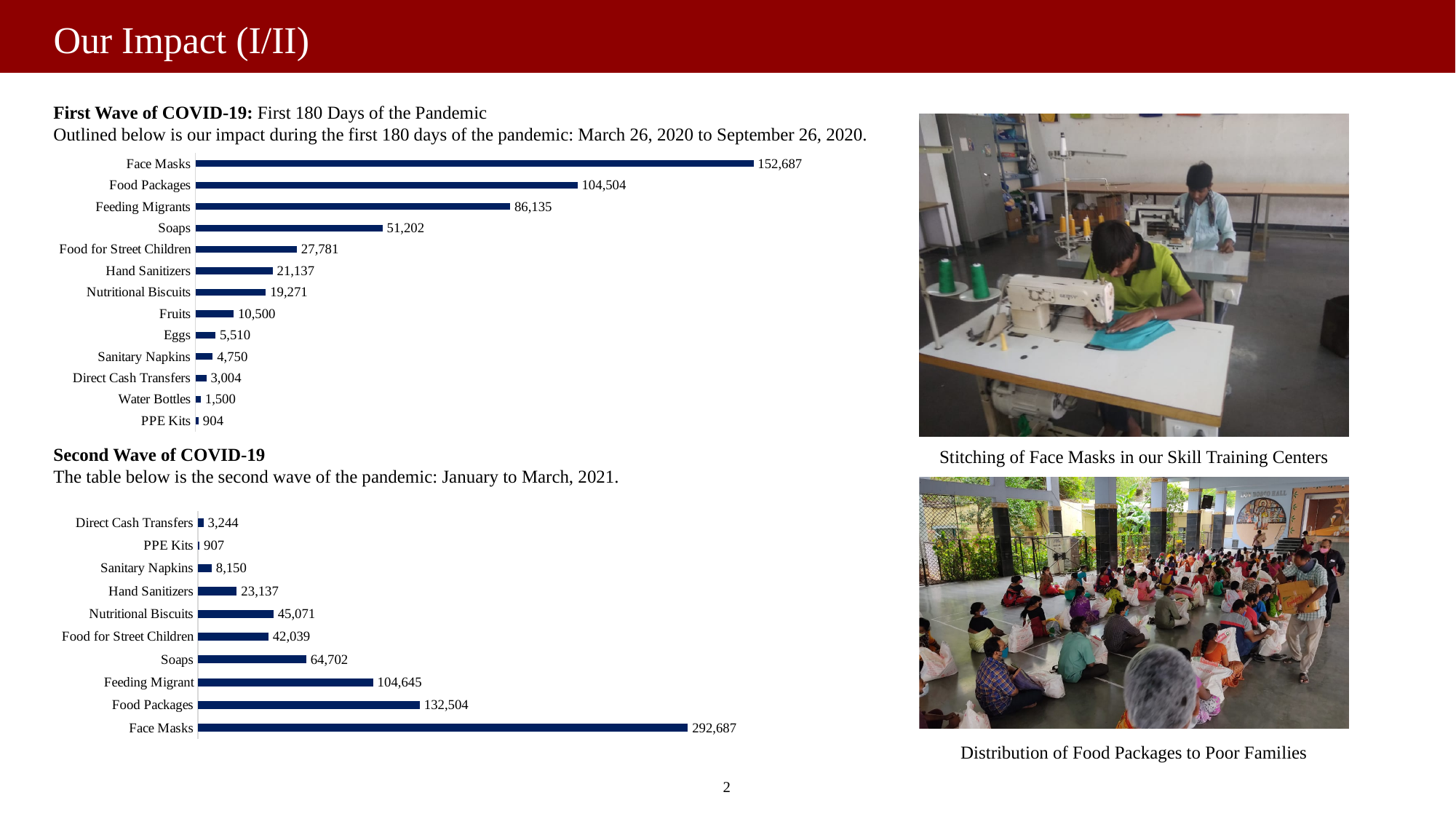
In the First Wave of COVID-19 chart, how many categories are shown? 13 In the Second Wave of COVID-19 chart, what is the value for Sanitary Napkins? 8,150 In the First Wave of COVID-19 chart, which category has the lowest value? PPE Kits In the First Wave of COVID-19 chart, what is the value for Soaps? 51,202 What type of chart is the Second Wave of COVID-19 chart? Bar chart In the First Wave of COVID-19 chart, what is the value for Face Masks? 152,687 In the Second Wave of COVID-19 chart, what is the difference between Nutritional Biscuits and Food for Street Children? 3,032 In the Second Wave of COVID-19 chart, how many categories are shown? 10 In the First Wave of COVID-19 chart, which is larger, Hand Sanitizers or Nutritional Biscuits? Hand Sanitizers In the Second Wave of COVID-19 chart, which category has the highest value? Face Masks In the First Wave of COVID-19 chart, what is the difference between Food Packages and Feeding Migrants? 18,369 In the Second Wave of COVID-19 chart, what is the value for Face Masks? 292,687